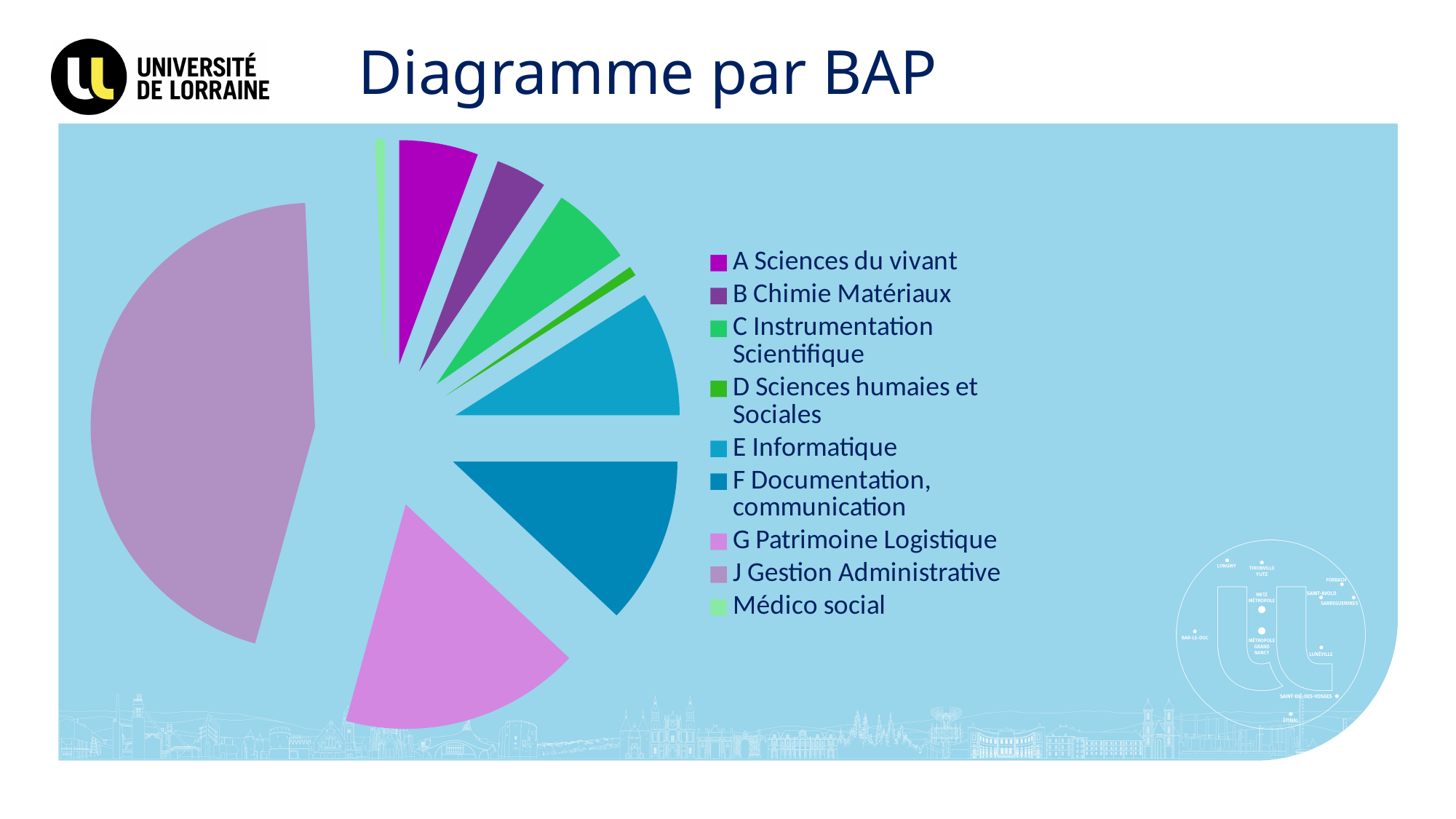
Which slice is larger: C Instrumentation Scientifique or D Sciences humaies et Sociales? C Instrumentation Scientifique Which slice is larger: J Gestion Administrative or F Documentation, communication? J Gestion Administrative Which slice is larger: G Patrimoine Logistique or A Sciences du vivant? G Patrimoine Logistique How many categories does the legend of the pie chart list? 9 Which legend entry is shown in light green? Médico social What kind of chart is shown on the slide? Pie chart Which category has the largest slice of the pie chart? J Gestion Administrative What is the title of the chart? Diagramme par BAP